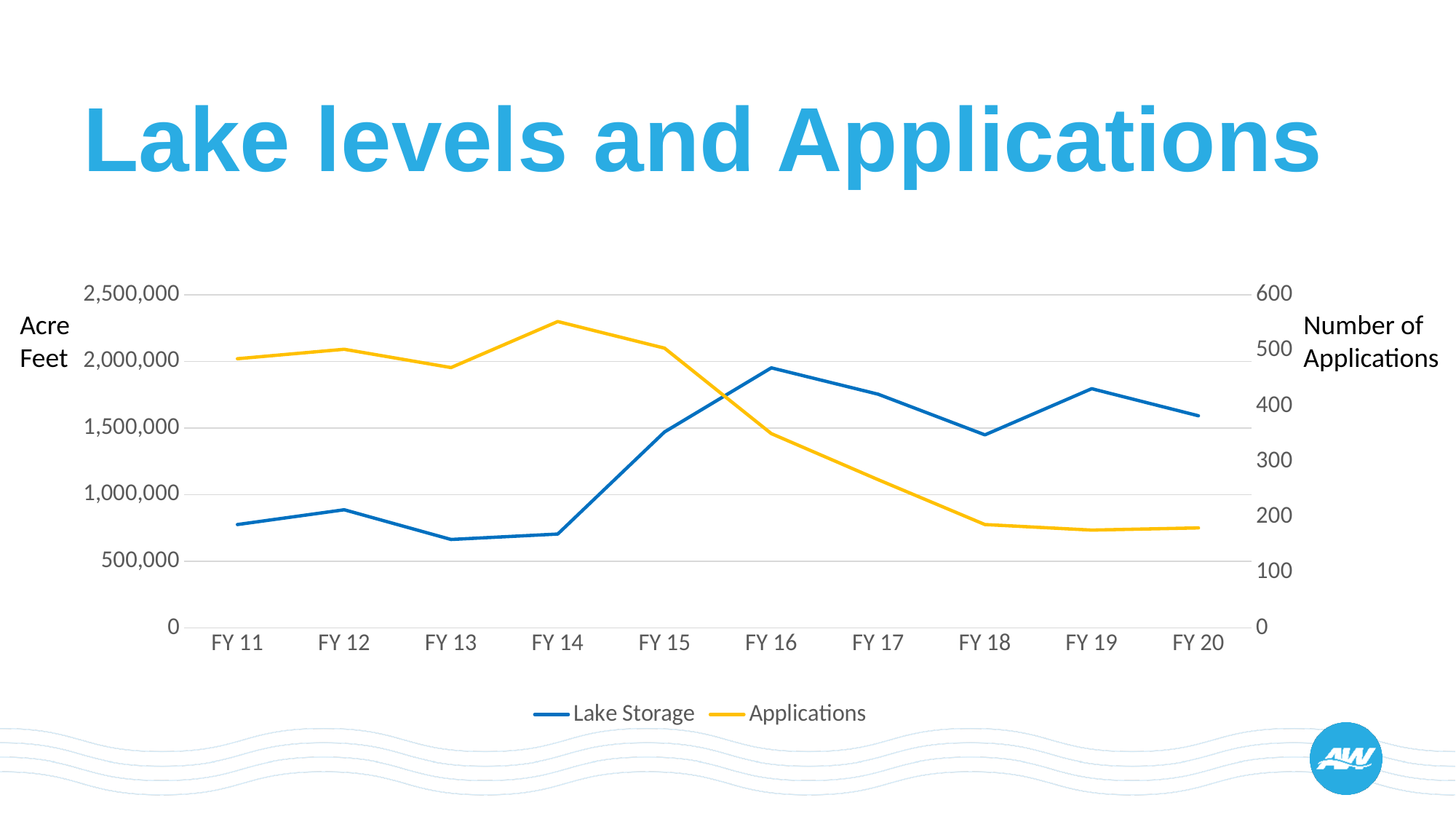
In which fiscal year is the number of Applications highest? FY 14 What kind of chart is shown on the slide? Line chart In which fiscal year is Lake Storage highest? FY 16 In which fiscal year is Lake Storage lowest? FY 13 Which fiscal year has the larger Lake Storage value, FY 16 or FY 18? FY 16 Do the Applications values rise or fall from FY 15 to FY 19? Fall Is the Applications value for FY 14 greater or less than 500? greater How many series does the legend list? 2 Is the Applications value for FY 18 greater or less than 300? less Is the Lake Storage value for FY 16 greater or less than 1,500,000? greater How many fiscal years are plotted along the x axis? 10